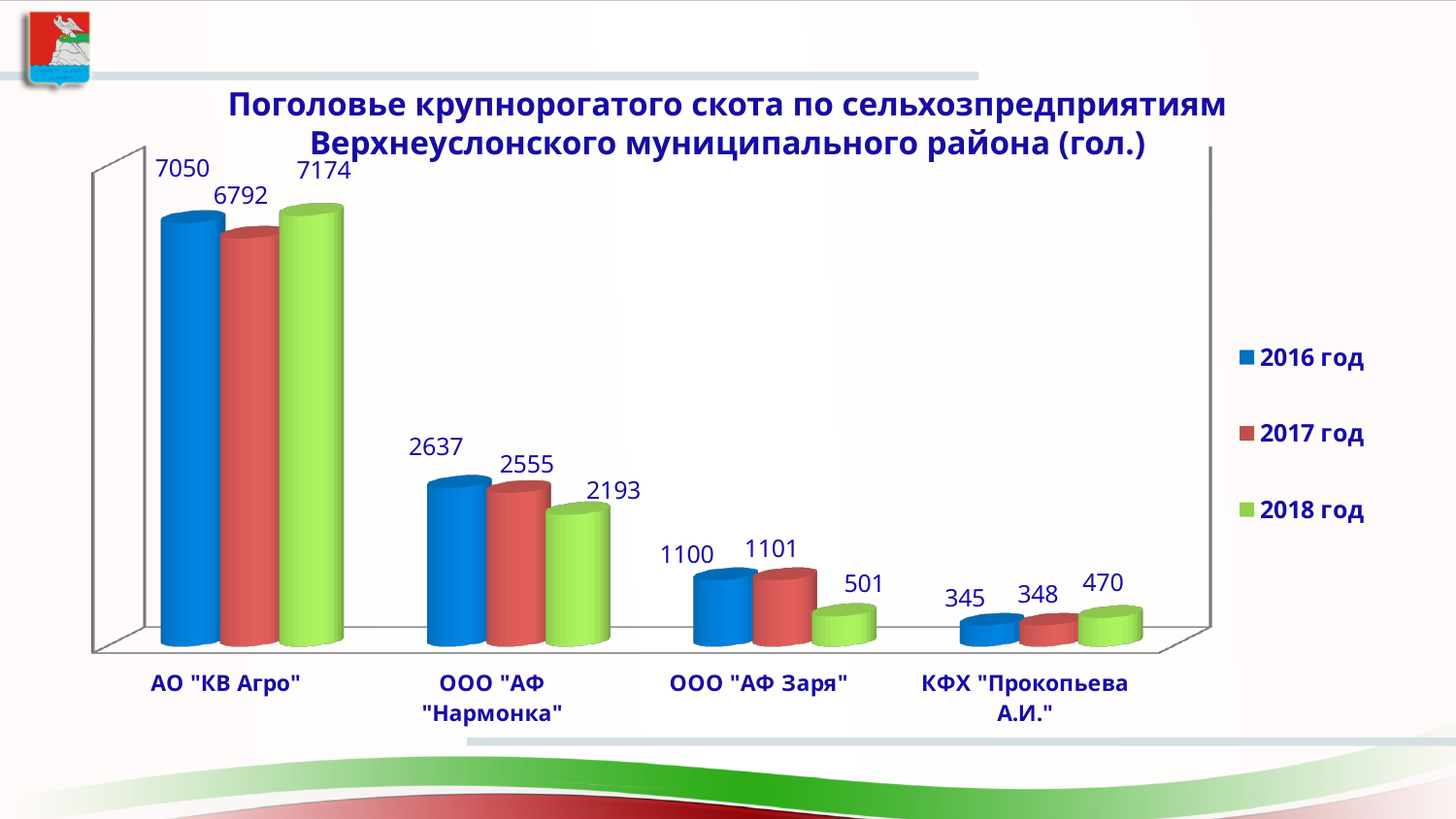
What is the value for ООО "АФ Заря" in 2018 год? 501 What is the value for АО "КВ Агро" in 2018 год? 7174 Which category has the lowest value in 2018 год? КФХ "Прокопьева А.И." How many series does the legend list? 3 What kind of chart is shown on the slide? Bar chart What is the value for ООО "АФ "Нармонка" in 2017 год? 2555 What is the difference between the 2016 год and 2017 год values for АО "КВ Агро"? 258 Which is larger for ООО "АФ Заря": the 2017 год value or the 2018 год value? 2017 год Do the 2018 год values rise or fall from АО "КВ Агро" to КФХ "Прокопьева А.И."? Fall Which category has the highest value in 2016 год? АО "КВ Агро" How many categories are shown on the x axis? 4 What is the value for КФХ "Прокопьева А.И." in 2016 год? 345